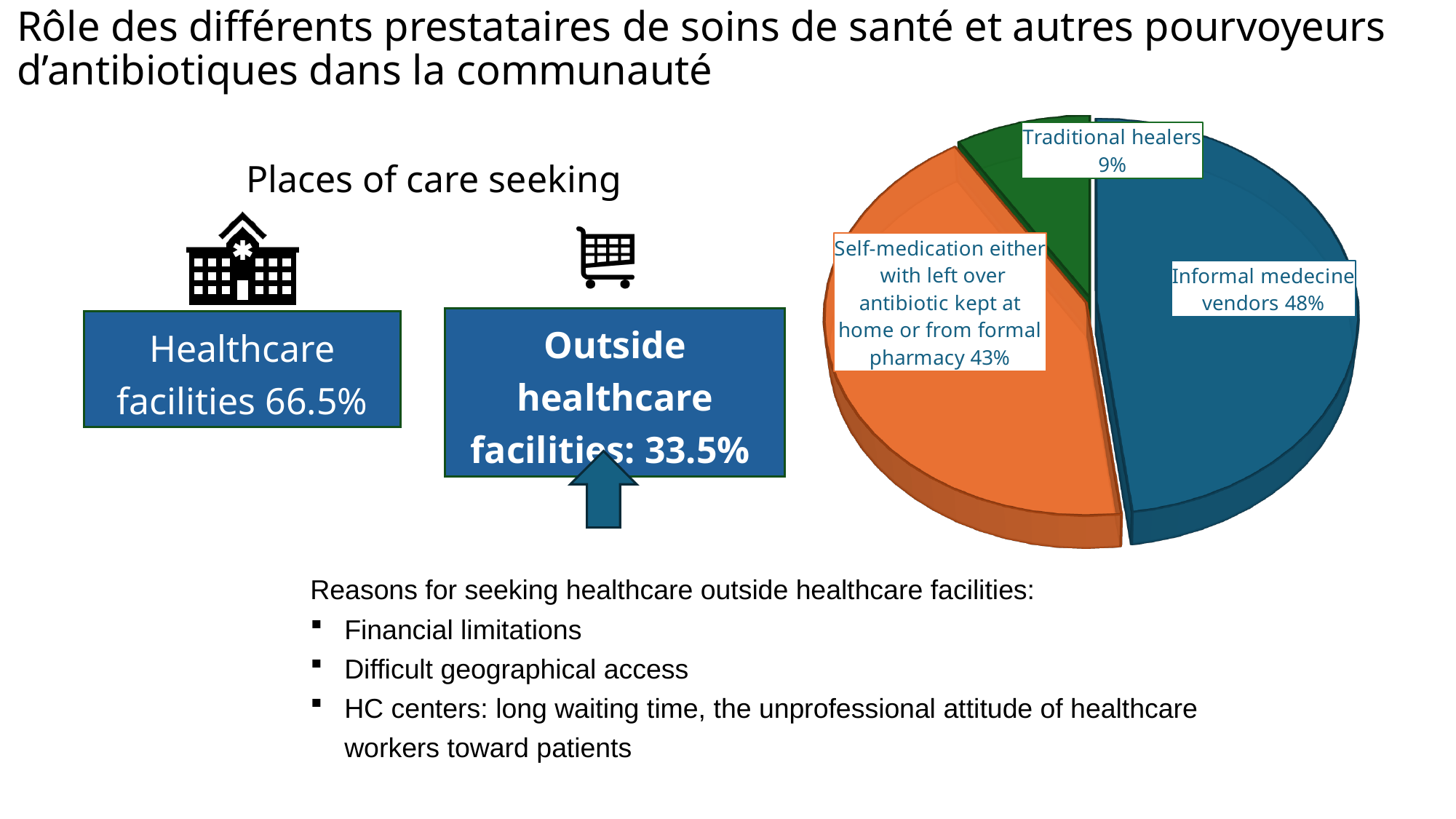
In the pie chart, what is the difference in percentage points between Informal medecine vendors and Self-medication? 5 In the pie chart, how many slices are there? 3 In the pie chart, what share is labelled for Traditional healers? 9% In the pie chart, which is larger: the Self-medication slice or the Traditional healers slice? Self-medication What kind of chart is shown on the right side of the slide? Pie chart In the pie chart, what colour is the Traditional healers slice? Green In the pie chart, what share is labelled for self-medication either with left over antibiotic kept at home or from formal pharmacy? 43% In the pie chart, which category has the largest slice? Informal medecine vendors In the pie chart, which category has the smallest slice? Traditional healers In the pie chart, what is the difference in percentage points between Informal medecine vendors and Traditional healers? 39 In the pie chart, what share is labelled for Informal medecine vendors? 48% In the pie chart, what colour is the Informal medecine vendors slice? Blue